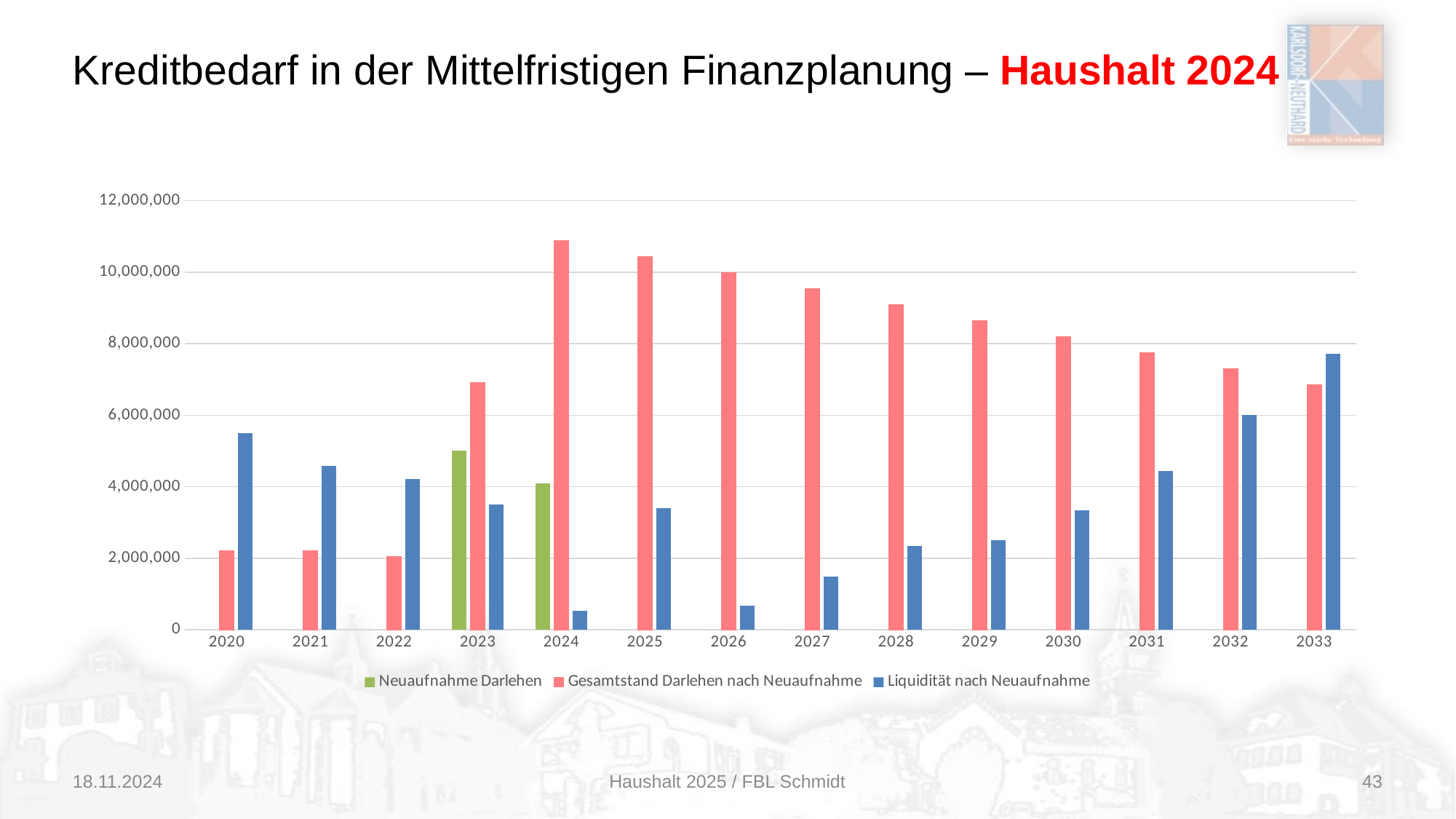
Is the value for Liquidität nach Neuaufnahme in 2020 greater or less than 4,000,000? greater How many series does the legend list? 3 Is the value for Gesamtstand Darlehen nach Neuaufnahme in 2033 greater or less than 8,000,000? less How many years are shown on the x axis? 14 Which series is shown in green in the legend? Neuaufnahme Darlehen Does the value for Gesamtstand Darlehen nach Neuaufnahme rise or fall from 2024 to 2033? fall In which year is the value for Liquidität nach Neuaufnahme highest? 2033 In which year is the value for Gesamtstand Darlehen nach Neuaufnahme highest? 2024 Is the value for Gesamtstand Darlehen nach Neuaufnahme in 2024 greater or less than 10,000,000? greater In 2033, which is larger: Gesamtstand Darlehen nach Neuaufnahme or Liquidität nach Neuaufnahme? Liquidität nach Neuaufnahme What kind of chart is shown on the slide? bar chart Which year has the larger value for Neuaufnahme Darlehen, 2023 or 2024? 2023